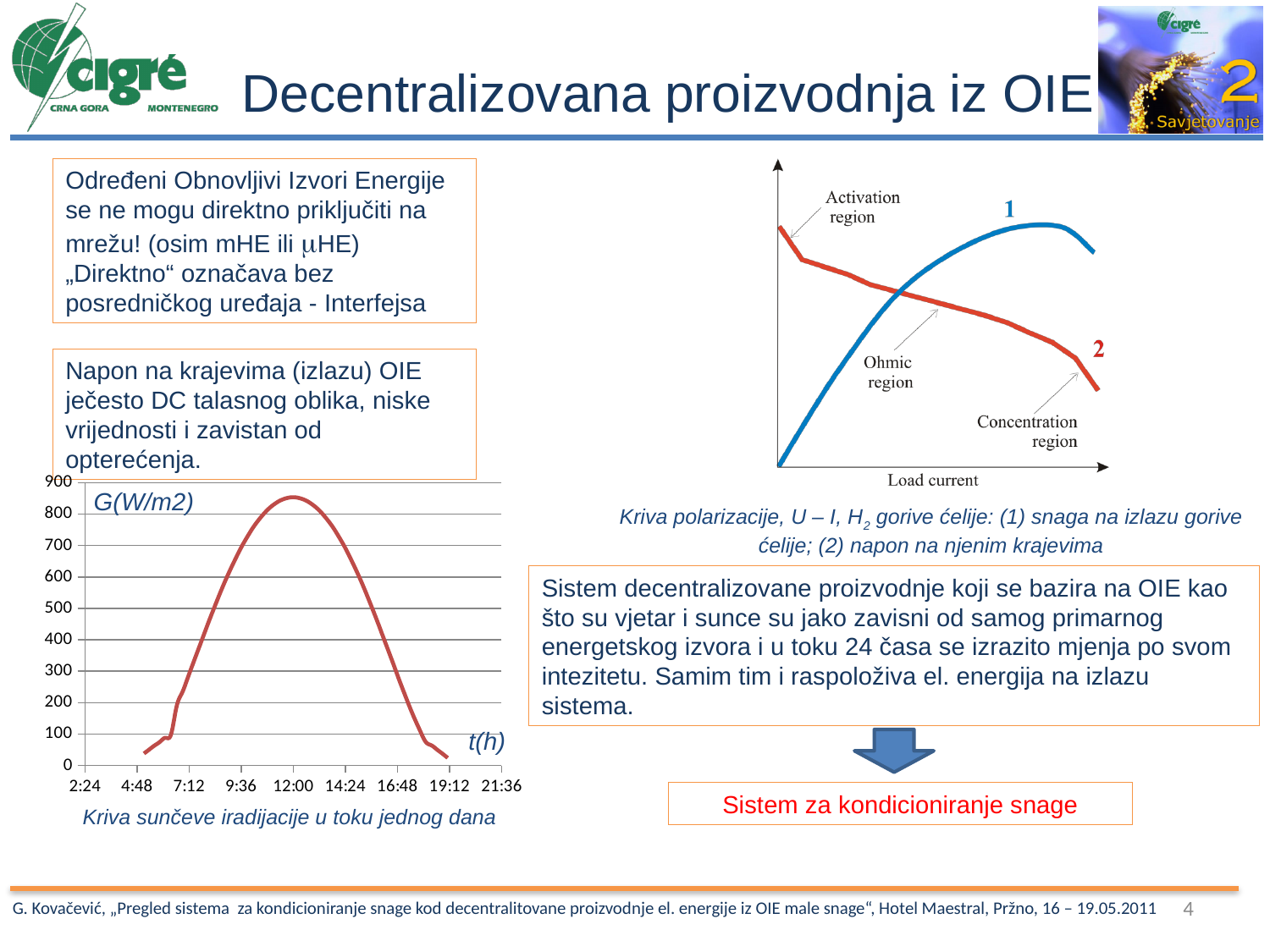
On the solar irradiation chart on the bottom left, at which time on the x axis does the curve reach its highest value? 12:00 On the solar irradiation chart on the bottom left, how does the curve behave from 12:00 to 19:12? it falls On the polarization curve chart on the right, what is the label of the x axis? Load current On the solar irradiation chart on the bottom left, which is larger, the value at 12:00 or the value at 7:12? 12:00 What kind of chart is the solar irradiation chart on the bottom left of the slide? line chart On the solar irradiation chart on the bottom left, is the value at 16:48 greater or less than 500? less On the solar irradiation chart on the bottom left, is the value at 19:12 greater or less than 100? less On the solar irradiation chart on the bottom left, what is the highest value shown on the y axis? 900 What kind of chart is the polarization curve chart on the right of the slide? line chart On the solar irradiation chart on the bottom left, is the value at 9:36 greater or less than 500? greater On the solar irradiation chart on the bottom left, how many time labels are shown on the x axis? 9